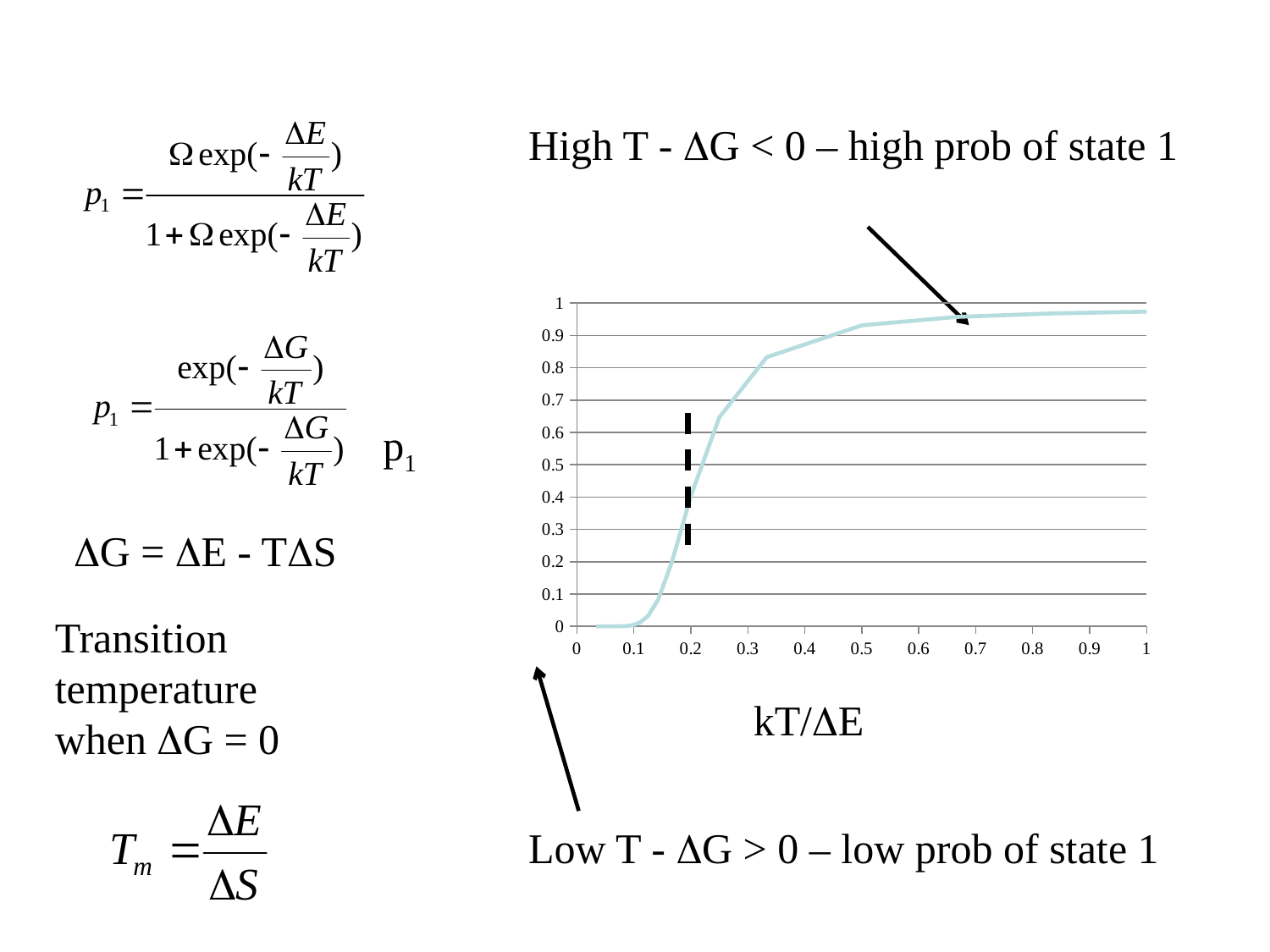
How many tick labels are shown on the x axis? 11 Is the value of p1 at kT/ΔE = 0.1 greater or less than 0.1? less What is the highest value shown on the y axis of the chart? 1 Is the value of p1 at kT/ΔE = 0.5 greater or less than 0.9? greater What kind of chart is shown on the slide? line chart Does the plotted value rise or fall as kT/ΔE increases along the x axis? rise Is the value of p1 at kT/ΔE = 1 greater or less than 0.9? greater At which labelled x-axis value is p1 highest? 1 What is the label of the x axis of the chart? kT/ΔE Which is larger, the value of p1 at kT/ΔE = 0.1 or at kT/ΔE = 0.5? kT/ΔE = 0.5